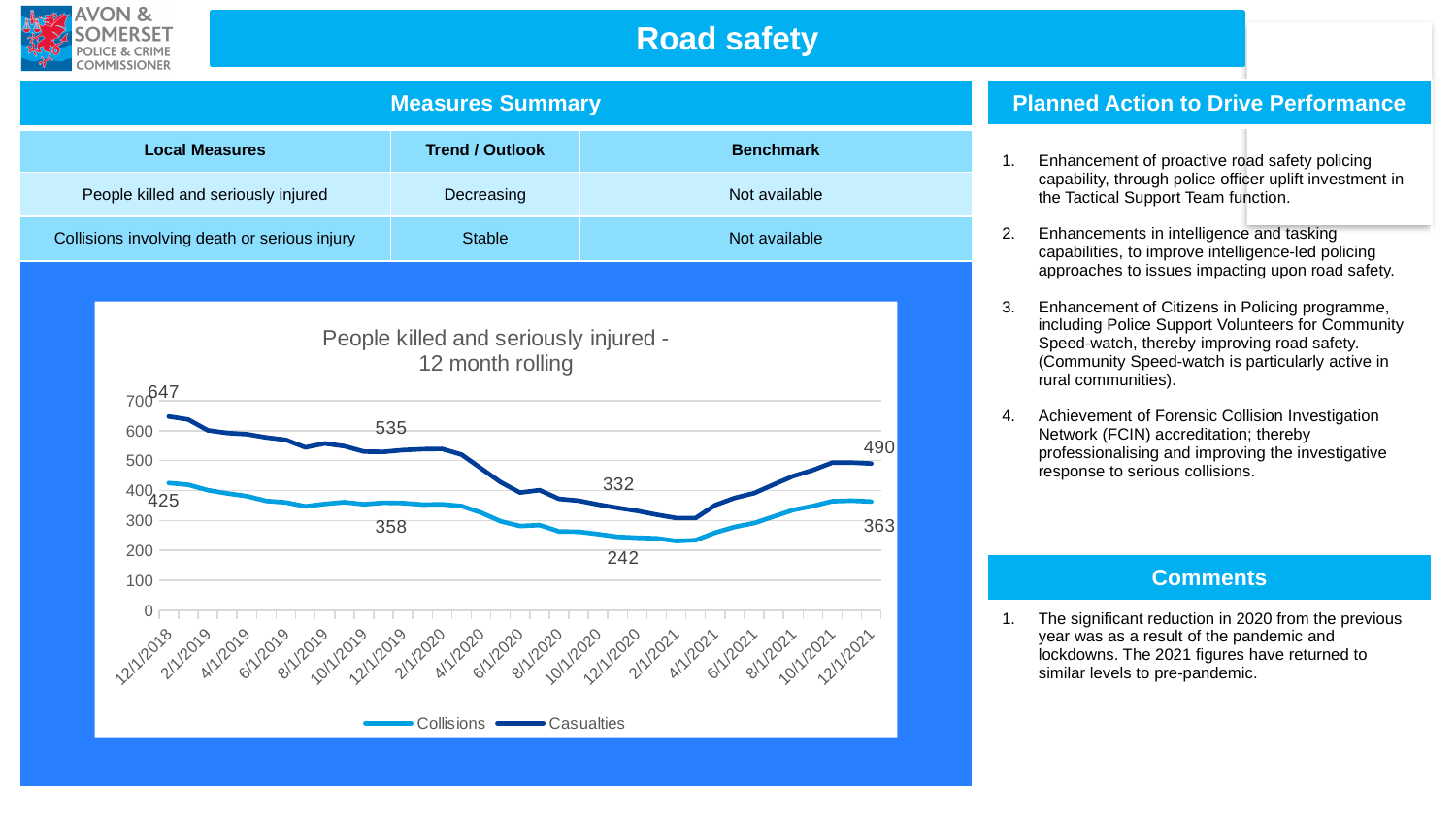
What is the labelled Collisions value at 12/1/2021? 363 What is the title of the chart? People killed and seriously injured - 12 month rolling What is the labelled Casualties value at 12/1/2021? 490 How many series does the chart legend list? 2 What is the labelled Casualties value at 12/1/2018? 647 Which series has the higher value at 12/1/2018, Collisions or Casualties? Casualties Is the Casualties value at 4/1/2021 greater or less than 400? less What is the labelled Collisions value at 12/1/2018? 425 What is the lowest labelled value on the Casualties line? 332 What is the lowest labelled value on the Collisions line? 242 By how much did the labelled Casualties value fall from 12/1/2018 (647) to 12/1/2021 (490)? 157 What type of chart is shown on the slide? line chart